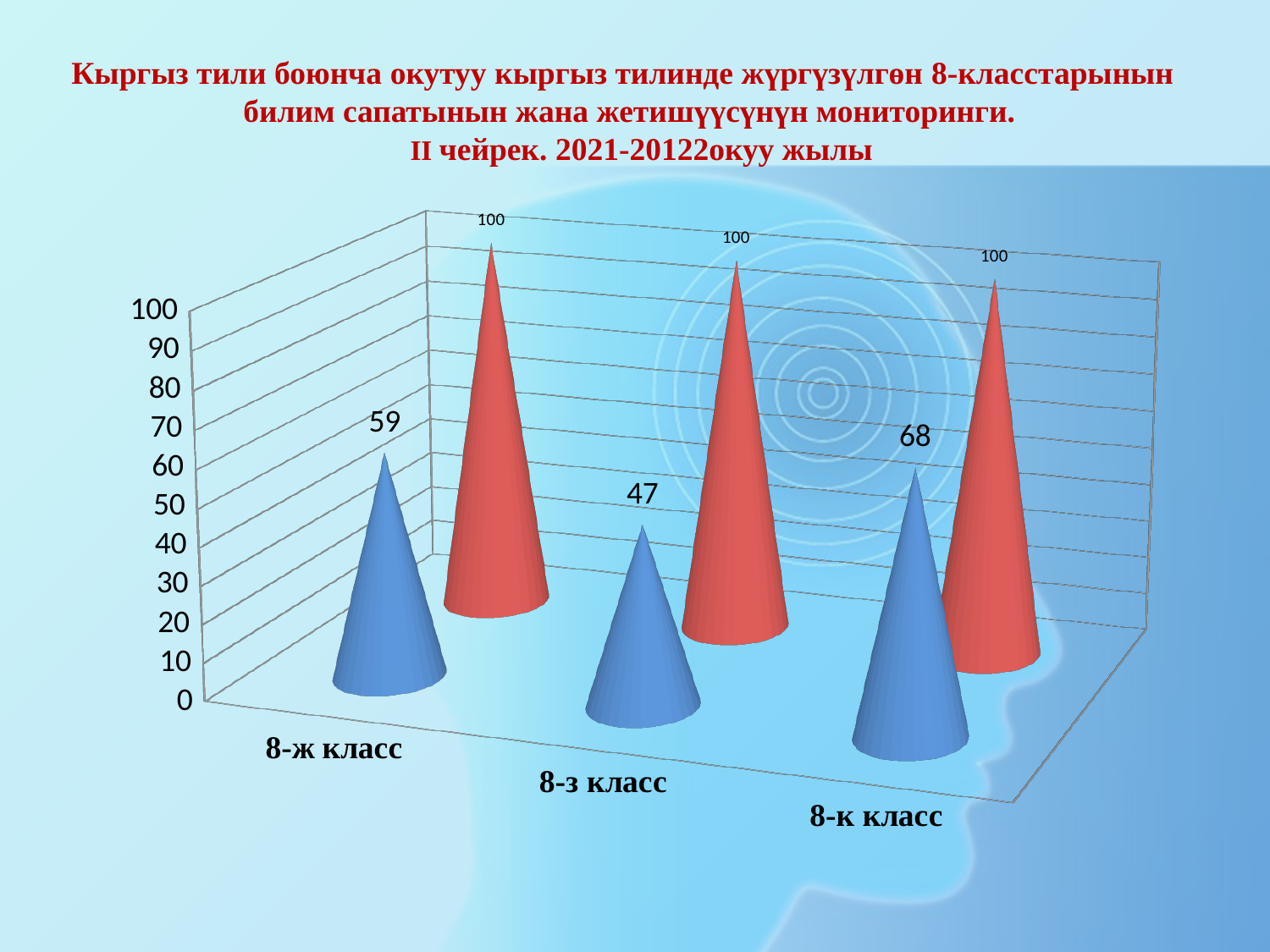
What is the difference between the blue bar values for 8-к класс and 8-з класс? 21 Which is larger, the blue bar for 8-ж класс or the blue bar for 8-з класс? 8-ж класс What is the value of the blue bar for 8-ж класс? 59 Which class has the highest blue bar value? 8-к класс How many classes are shown on the x axis? 3 What value do all three red bars share? 100 What type of chart is shown on the slide? bar chart What is the value of the blue bar for 8-к класс? 68 What is the value of the blue bar for 8-з класс? 47 What is the value of the red bar for 8-з класс? 100 Which class has the lowest blue bar value? 8-з класс What is the difference between the red and blue bar values for 8-ж класс? 41